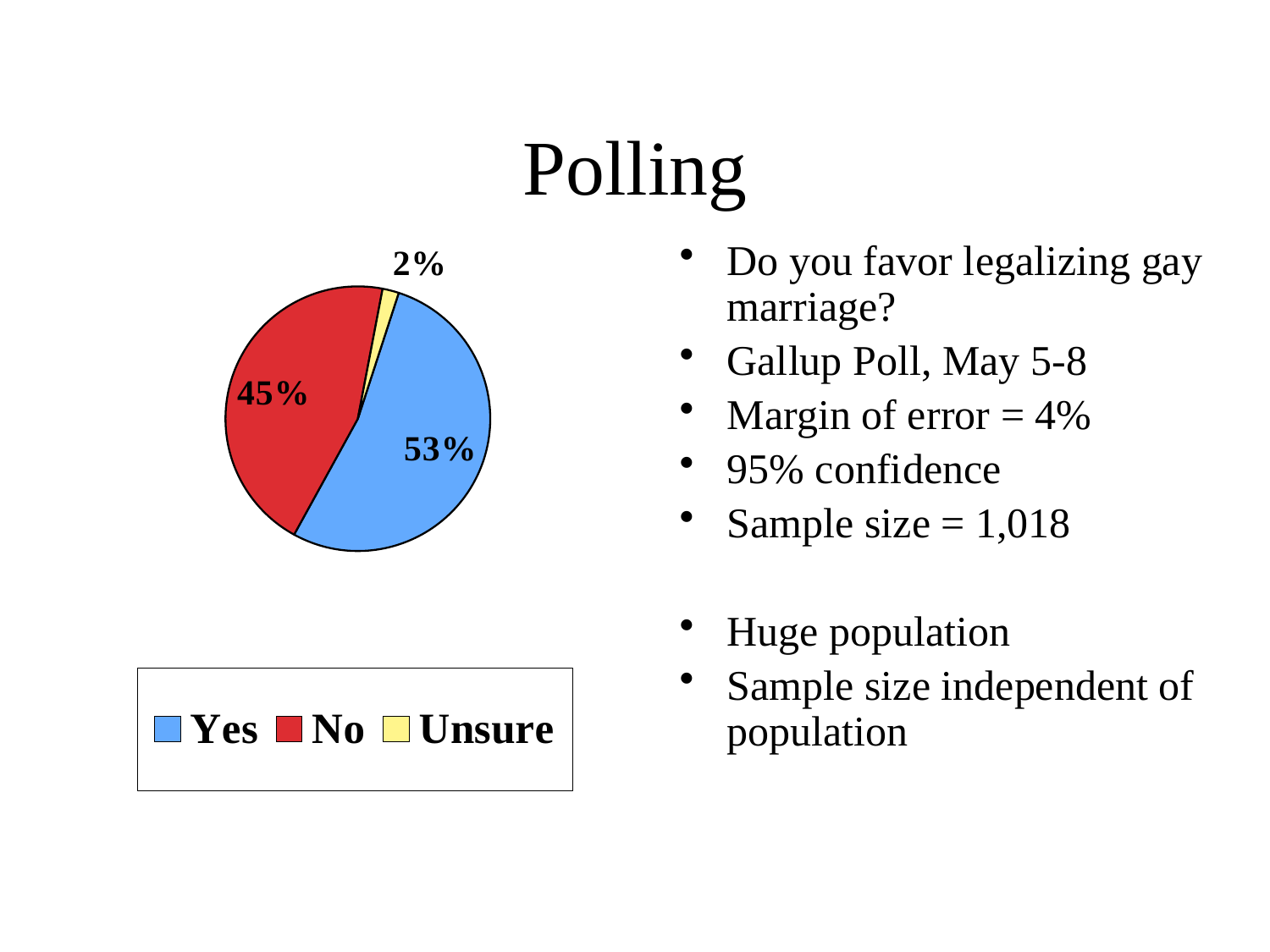
Which slice of the pie is the smallest? Unsure What percentage of the pie is labelled Yes? 53% Which slice is larger, Yes or No? Yes What percentage of the pie is labelled No? 45% What colour is the No slice in the pie chart? red How many slices does the pie chart have? 3 What is the combined share of the No and Unsure slices? 47% How many entries does the legend list? 3 Which slice of the pie is the largest? Yes What percentage of the pie is labelled Unsure? 2% What kind of chart is shown on the slide? pie chart What is the difference in percentage points between the Yes and No slices? 8%